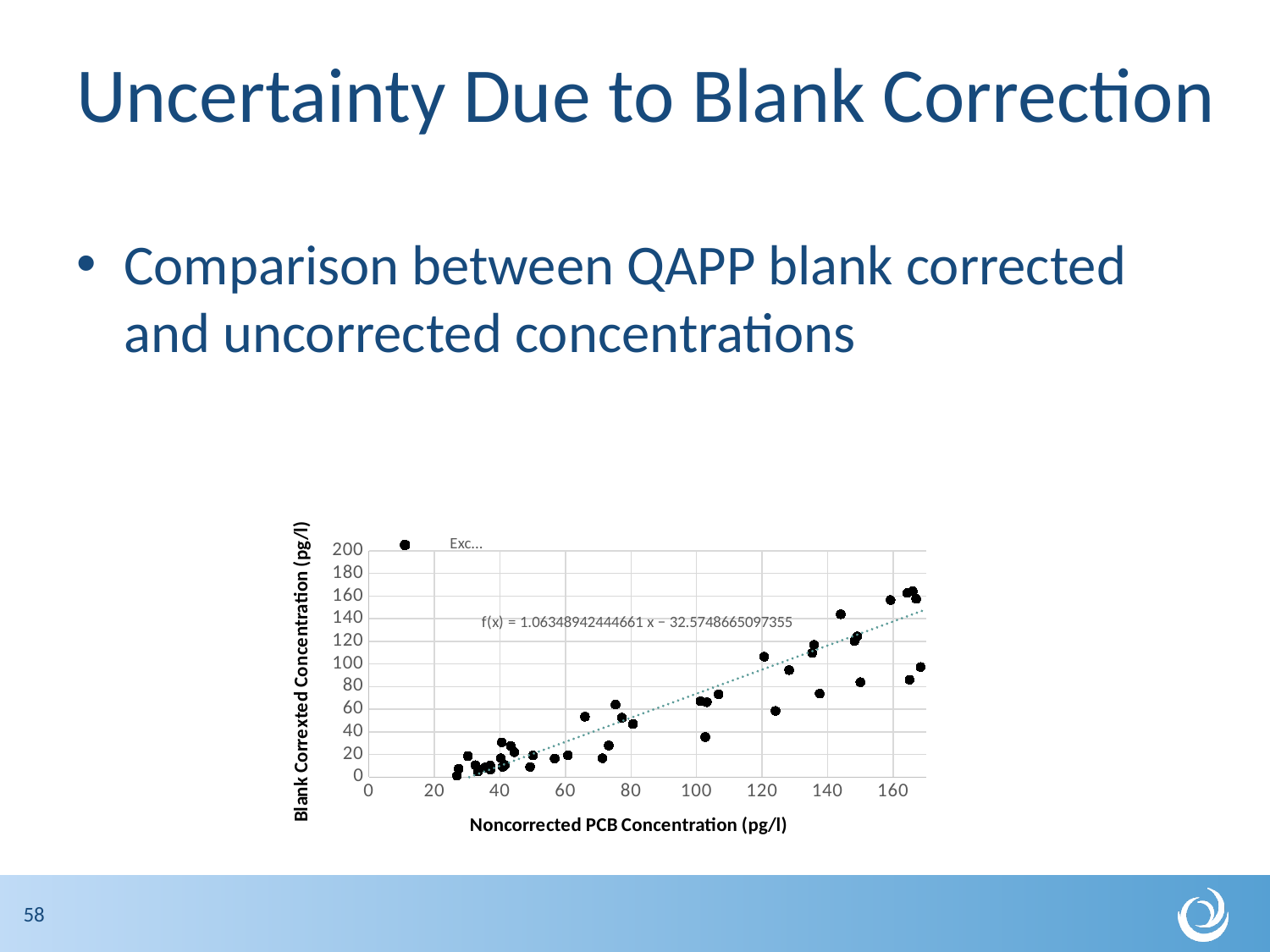
What is the highest tick value shown on the y axis of the chart? 200 What is the intercept of the fitted trendline equation shown on the chart? −32.5748665097355 What kind of chart is shown on the slide? Scatter chart Do the blank corrected concentrations generally rise or fall as the noncorrected PCB concentration increases? Rise Is the smallest plotted noncorrected PCB concentration greater or less than 40? less What is the highest tick value shown on the x axis of the chart? 160 What is the title of the x axis of the chart? Noncorrected PCB Concentration (pg/l) What is the slope of the fitted trendline equation shown on the chart? 1.06348942444661 Is the highest plotted blank corrected concentration greater or less than 140? greater What is the title of the y axis of the chart? Blank Correxted Concentration (pg/l) Is the lowest plotted blank corrected concentration greater or less than 20? less